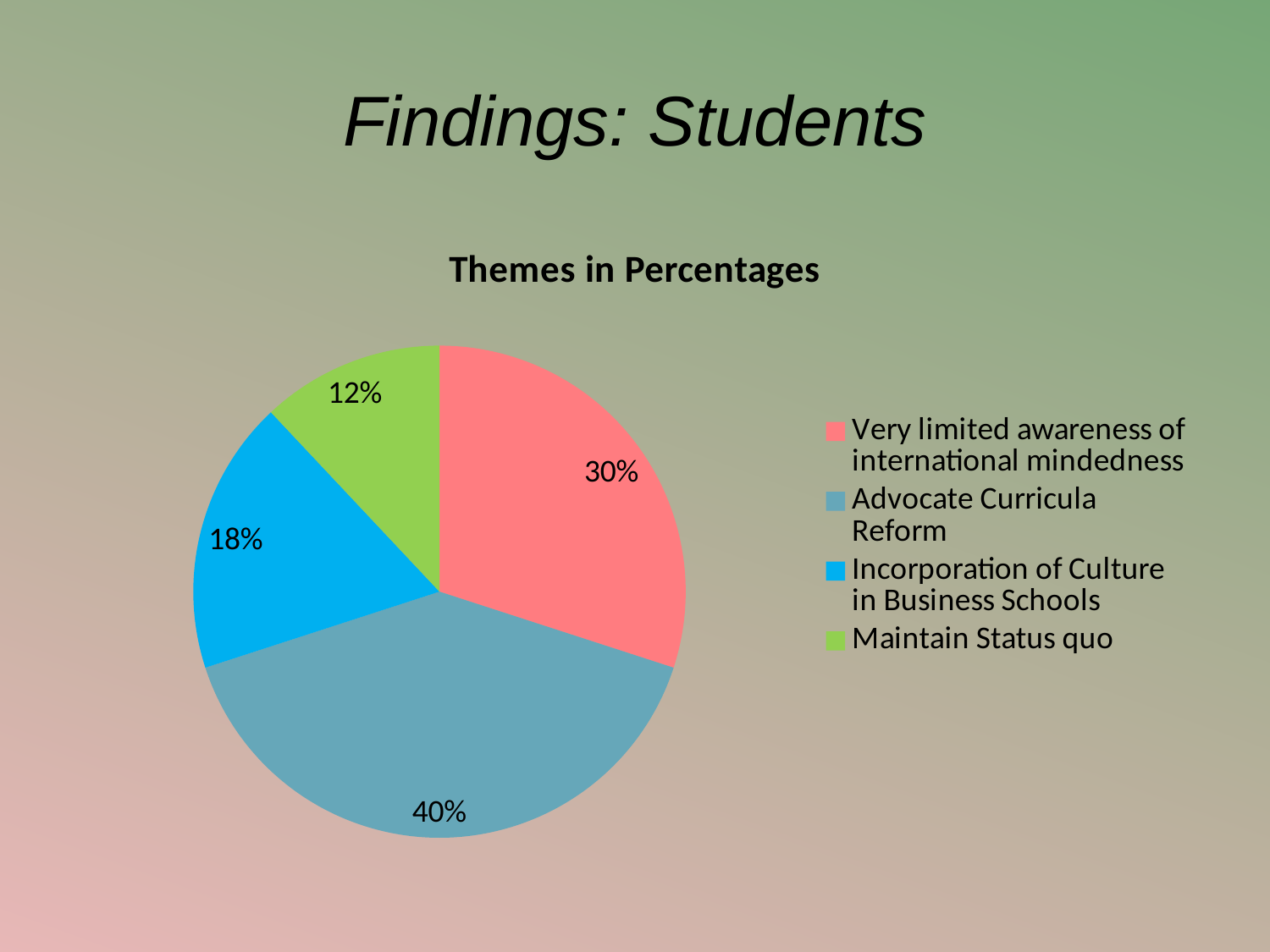
How many slices does the pie chart have? 4 What percentage is shown for Incorporation of Culture in Business Schools? 18% Which is larger: the share for Incorporation of Culture in Business Schools or the share for Maintain Status quo? Incorporation of Culture in Business Schools What percentage is shown for Very limited awareness of international mindedness? 30% What percentage is shown for Maintain Status quo? 12% What is the title of the chart? Themes in Percentages Which theme has the smallest share of the pie? Maintain Status quo What is the difference in percentage points between Advocate Curricula Reform and Very limited awareness of international mindedness? 10 What percentage is shown for Advocate Curricula Reform? 40% What kind of chart is shown on the slide? pie chart Which theme has the largest share of the pie? Advocate Curricula Reform What colour is the slice for Maintain Status quo? green